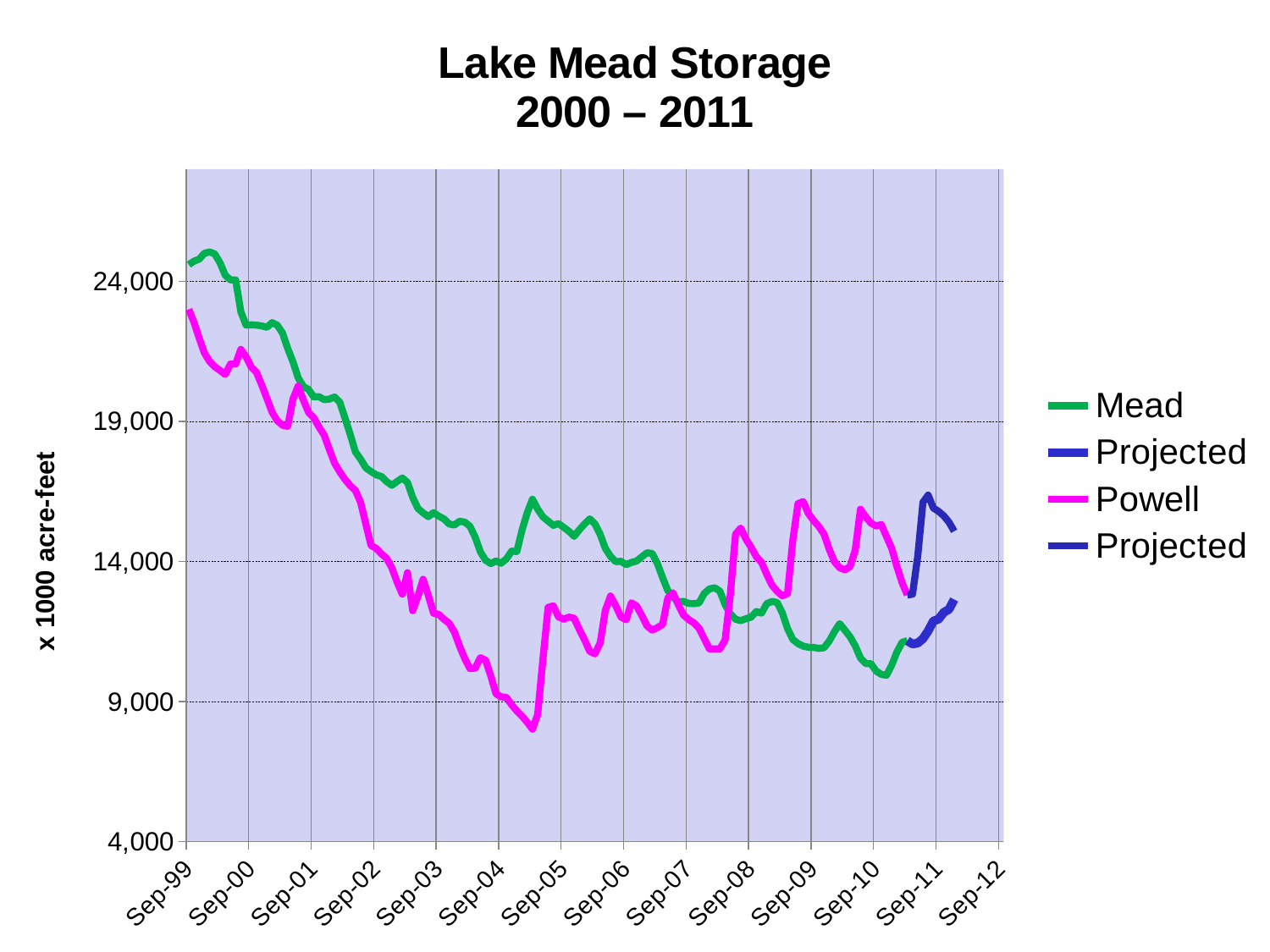
Does the Mead series generally rise or fall from Sep-99 to Sep-10? fall Is the value for Powell at Sep-99 greater or less than 24,000? less Is the value for Mead at Sep-10 greater or less than 14,000? less What is the title of the chart? Lake Mead Storage 2000 – 2011 What kind of chart is shown on the slide? line chart At Sep-09, which series has the higher value, Mead or Powell? Powell What is the label on the vertical axis? x 1000 acre-feet How many series does the legend list? 4 Is the lowest value reached by the Powell series greater or less than 9,000? less Which series reaches the lowest value on the chart? Powell At Sep-99, which series has the higher value, Mead or Powell? Mead